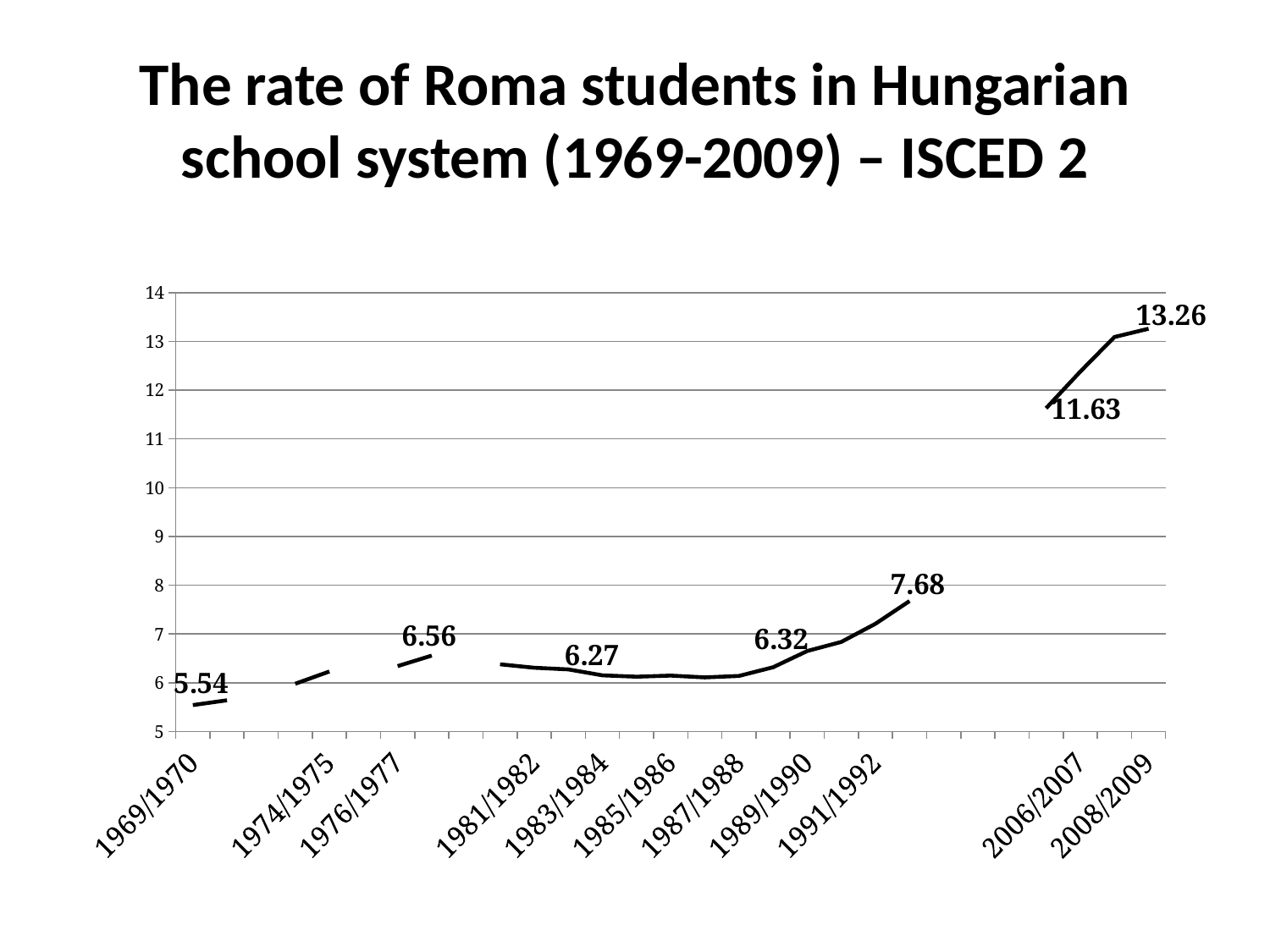
What type of chart is shown on the slide? line chart What is the title of the chart? The rate of Roma students in Hungarian school system (1969-2009) – ISCED 2 What is the rate of Roma students for 2008/2009? 13.26 Overall, does the rate rise or fall from 1969/1970 to 2008/2009? rise What is the rate of Roma students for 1969/1970? 5.54 Is the value for 1974/1975 greater or less than 7? less What value is labelled at 1983/1984? 6.27 What value is labelled at 1989/1990? 6.32 What is the difference between the rate for 2008/2009 and the rate for 1969/1970? 7.72 Which school year has the lowest labelled rate? 1969/1970 Which school year has the highest labelled rate? 2008/2009 Which is larger, the rate for 1989/1990 or the rate for 1983/1984? 1989/1990